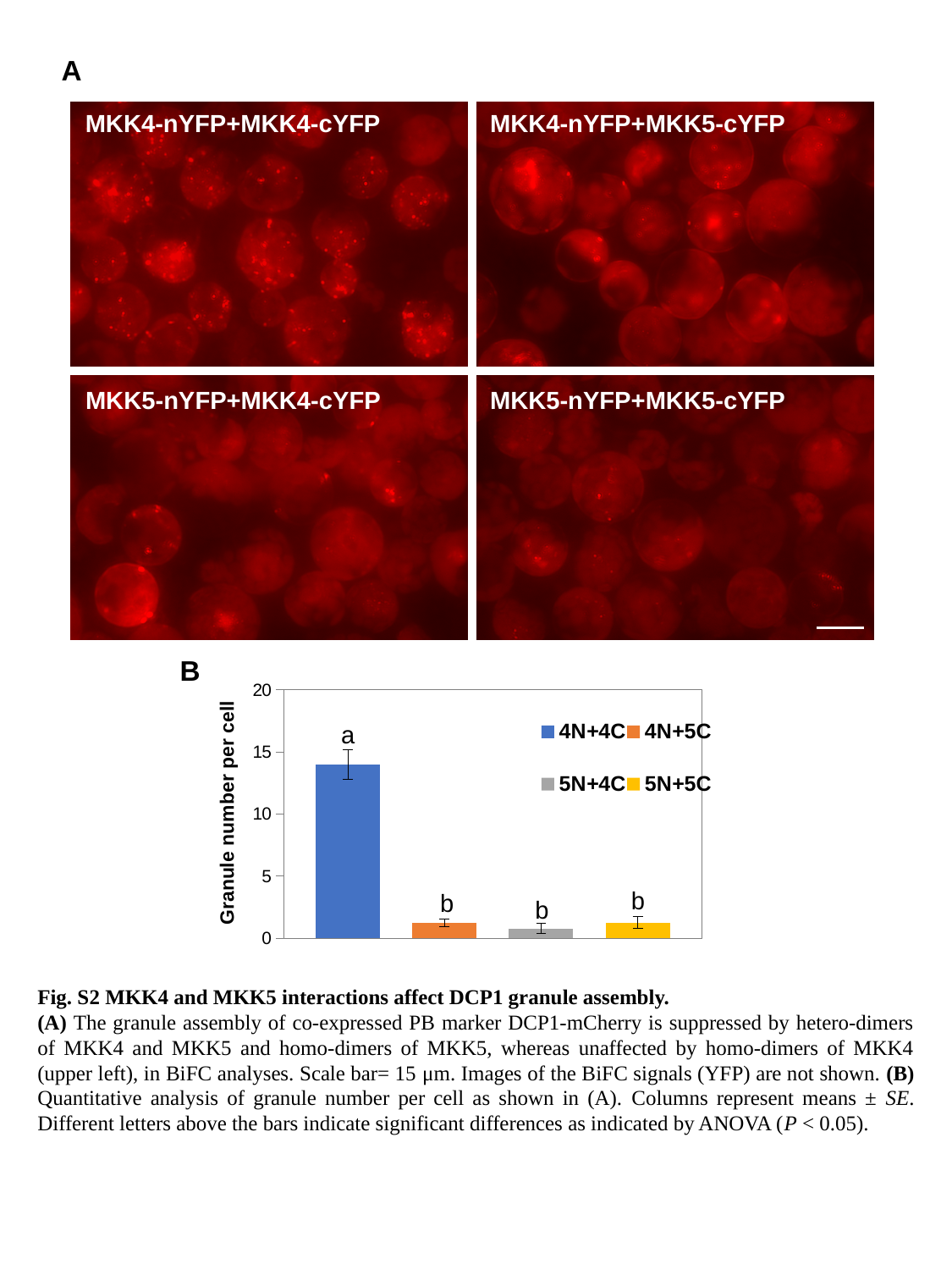
In the chart in panel B, is the value for 5N+5C greater or less than 5? less What is the y-axis title of the chart in panel B? Granule number per cell In the chart in panel B, which is larger, the value for 4N+4C or the value for 5N+5C? 4N+4C In the chart in panel B, which is larger, the value for 4N+4C or the value for 5N+4C? 4N+4C In the chart in panel B, is the value for 4N+5C greater or less than 5? less What kind of chart is shown in panel B? bar chart In the chart in panel B, is the value for 4N+4C greater or less than 15? less In the chart in panel B, which series has the highest granule number per cell? 4N+4C In the chart in panel B, what is the maximum value shown on the y axis? 20 In the chart in panel B, what colour is the bar for 4N+4C? blue How many series does the legend of the chart in panel B list? 4